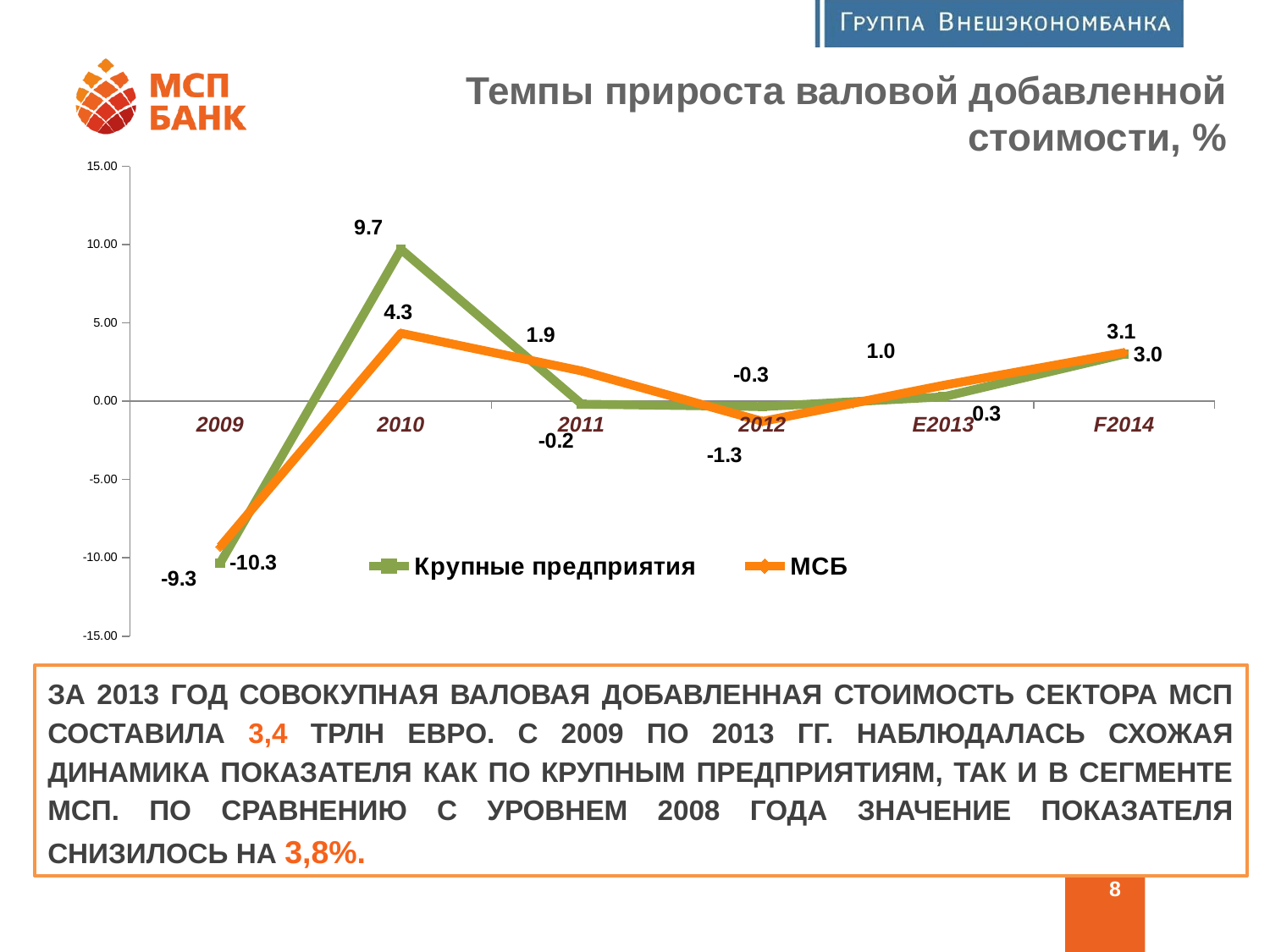
How many series does the legend list? 2 In which year does the МСБ series have its lowest value? 2009 What is the value for Крупные предприятия in 2010? 9.7 What is the difference between Крупные предприятия and МСБ in 2010? 5.4 What kind of chart is shown on the slide? Line chart What is the value for МСБ in 2012? -1.3 In which year does the Крупные предприятия series reach its highest value? 2010 How many years are shown on the x axis? 6 What is the title of the chart? Темпы прироста валовой добавленной стоимости, % What is the value for Крупные предприятия in F2014? 3.0 What is the value for МСБ in 2009? -9.3 Which series has the larger value in 2011, Крупные предприятия or МСБ? МСБ